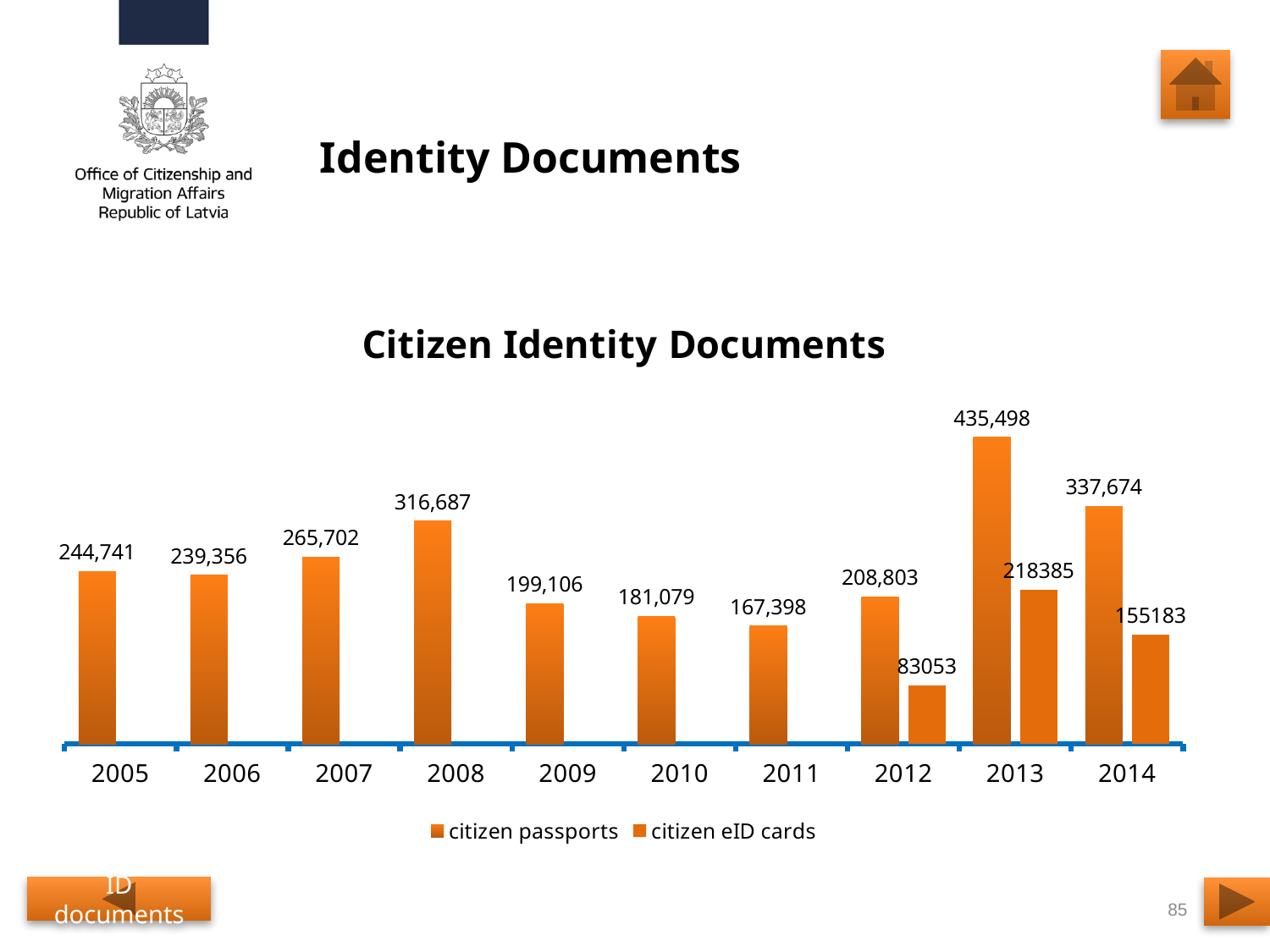
What is the difference between citizen passports in 2013 and 2014? 97,824 What is the value for citizen passports in 2008? 316,687 What is the value for citizen passports in 2013? 435,498 In which year was the number of citizen passports highest? 2013 What is the value for citizen eID cards in 2014? 155183 How many years are shown on the x axis? 10 What is the difference between citizen passports and citizen eID cards in 2013? 217,113 Which is larger in 2014: citizen passports or citizen eID cards? citizen passports In which year was the number of citizen passports lowest? 2011 What is the value for citizen eID cards in 2012? 83053 What kind of chart is shown? bar chart How many series does the legend list? 2